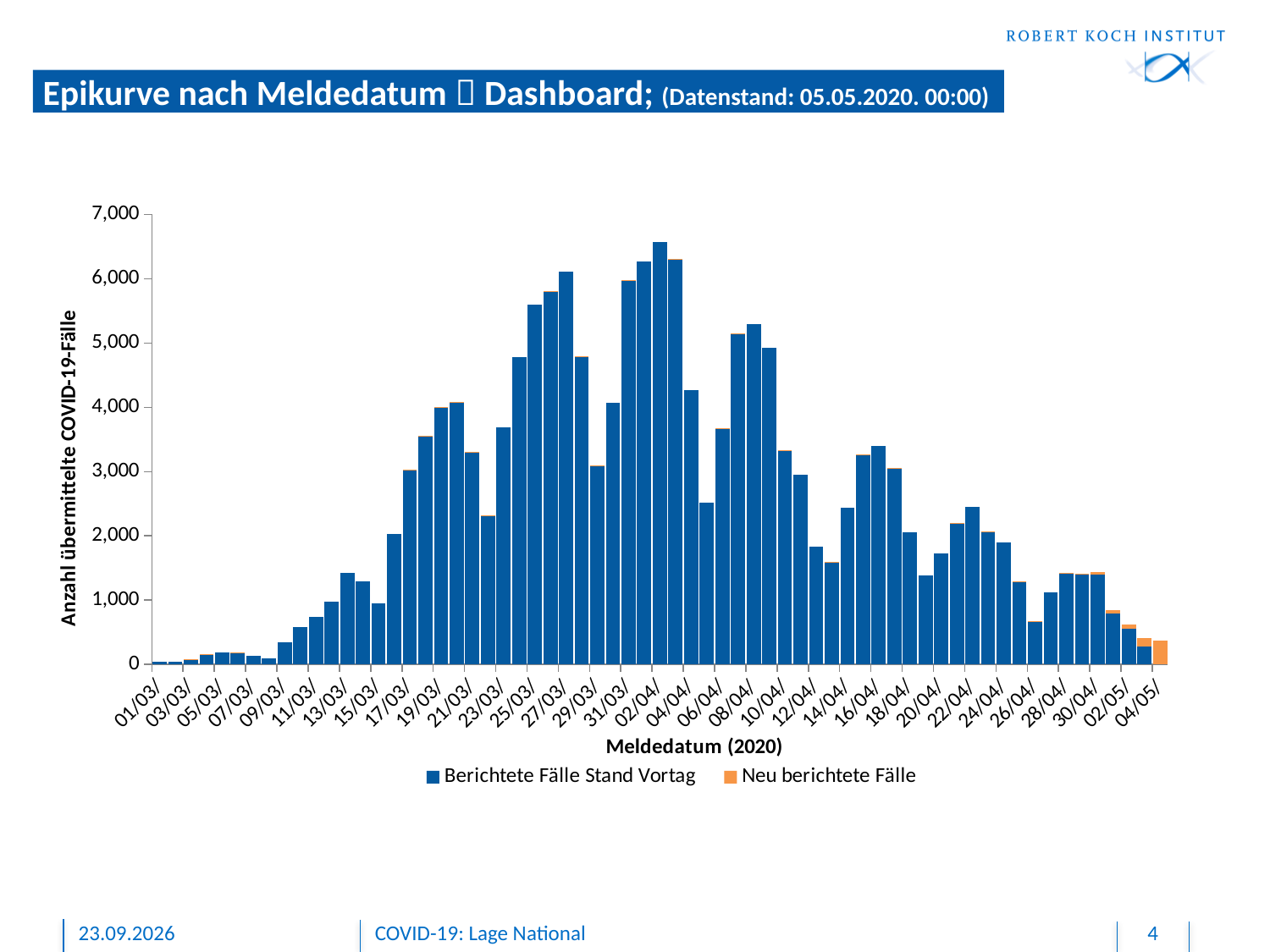
What is the title of the y axis? Anzahl übermittelte COVID-19-Fälle Is the value for 26/04 greater or less than 1,000? less Do the values generally rise or fall from 02/04 to 04/05? fall Is the value for 13/03 greater or less than 1,000? greater How many series does the legend list? 2 Which is larger, the value for 02/04 or the value for 04/04? 02/04 Which legend entry is shown in orange? Neu berichtete Fälle What kind of chart is shown on the slide? bar chart Is the value for 25/03 greater or less than 5,000? greater Which date has the highest bar in the chart? 02/04